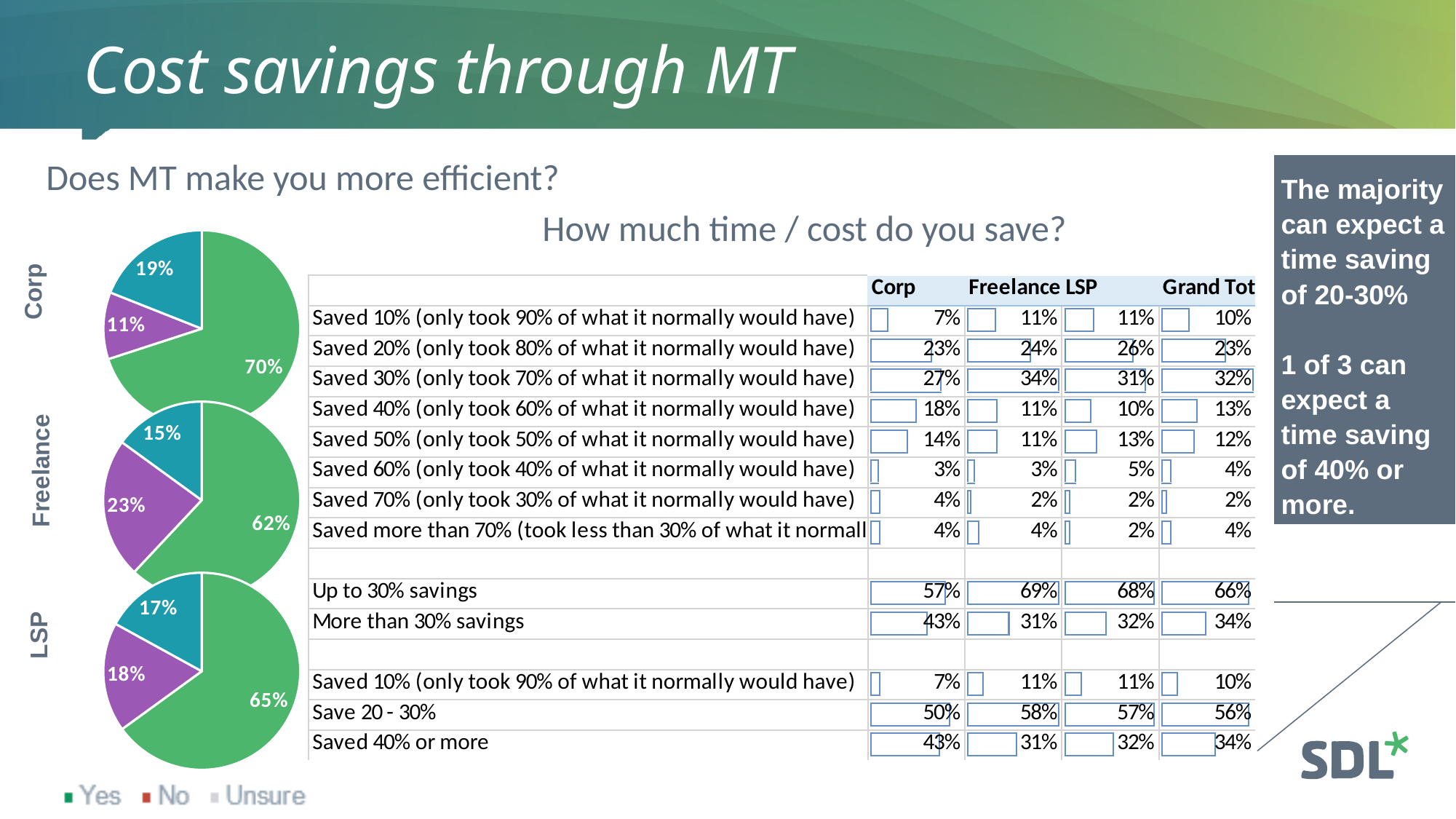
In the LSP pie chart, what is the value of the smallest slice? 17% In the Corp pie chart, what is the difference between the largest slice (70%) and the smallest slice (11%)? 59 percentage points How many pie charts are shown on the slide? 3 In the Corp pie chart, what is the value of the largest slice? 70% In the Freelance pie chart, what is the value of the largest slice? 62% In the Freelance pie chart, what is the value of the smallest slice? 15% What are the legend entries for the pie charts? Yes, No, Unsure In the LSP pie chart, what is the value of the largest slice? 65% What kind of charts are shown on the left side of the slide under 'Does MT make you more efficient?' Pie charts In the Corp pie chart, what is the value of the smallest slice? 11% Which pie chart has the larger biggest slice, Corp or Freelance? Corp How many slices does the Corp pie chart have? 3